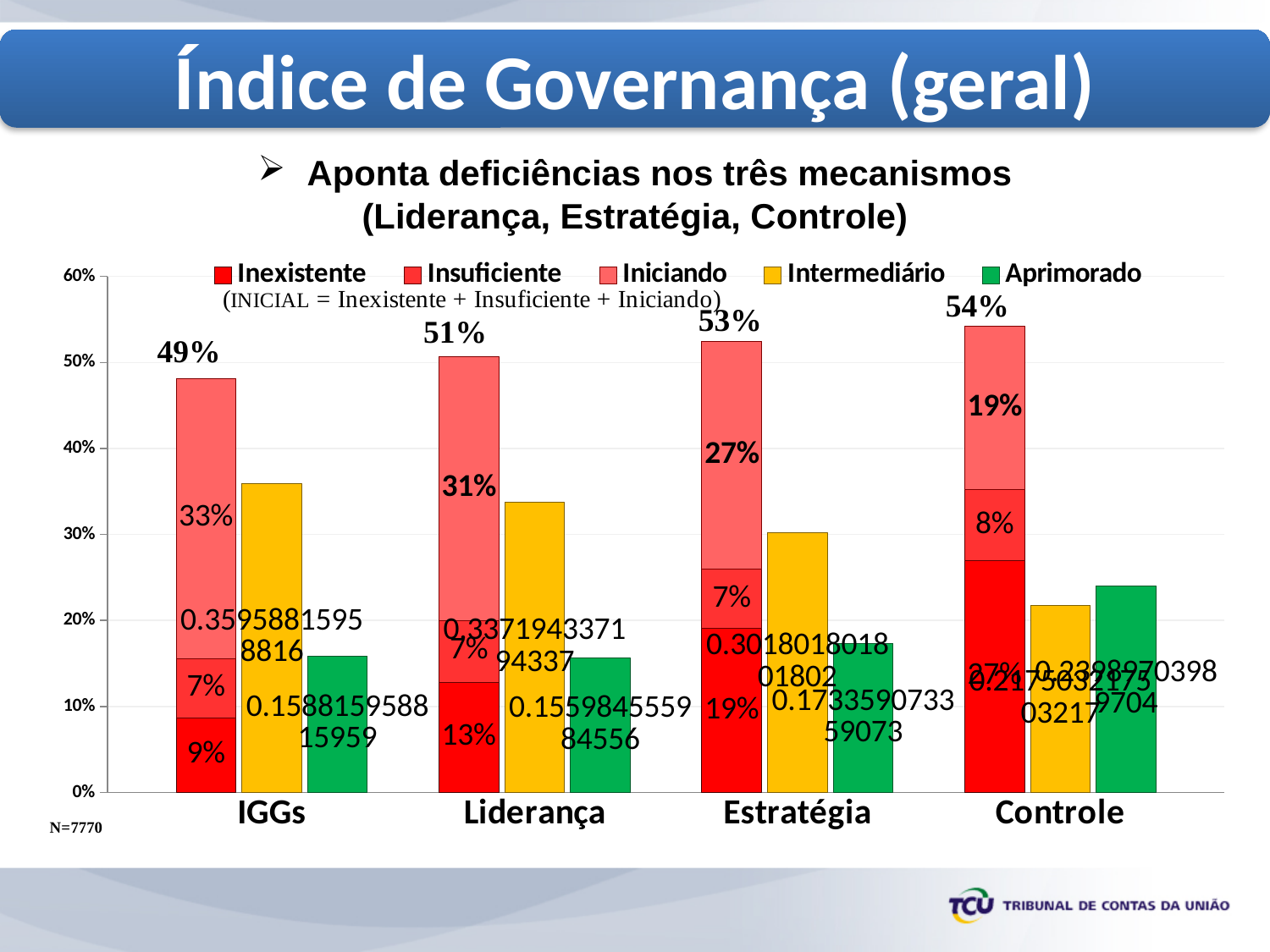
What is the Inexistente value for IGGs? 9% How many series does the legend list? 5 Do the INICIAL totals rise or fall from IGGs to Controle along the x axis? rise Is the Intermediário value for IGGs greater or less than 30%? greater How many categories are shown on the x axis? 4 What kind of chart is shown on the slide? bar chart What is the Iniciando value for Controle? 19% What is the Insuficiente value for Estratégia? 7% Which category has the highest INICIAL total (Inexistente + Insuficiente + Iniciando)? Controle Which is larger, the Inexistente value for Estratégia or the Inexistente value for Liderança? Estratégia What is the difference between the INICIAL total for Controle and the INICIAL total for IGGs? 5 percentage points Which category has the lowest INICIAL total (Inexistente + Insuficiente + Iniciando)? IGGs